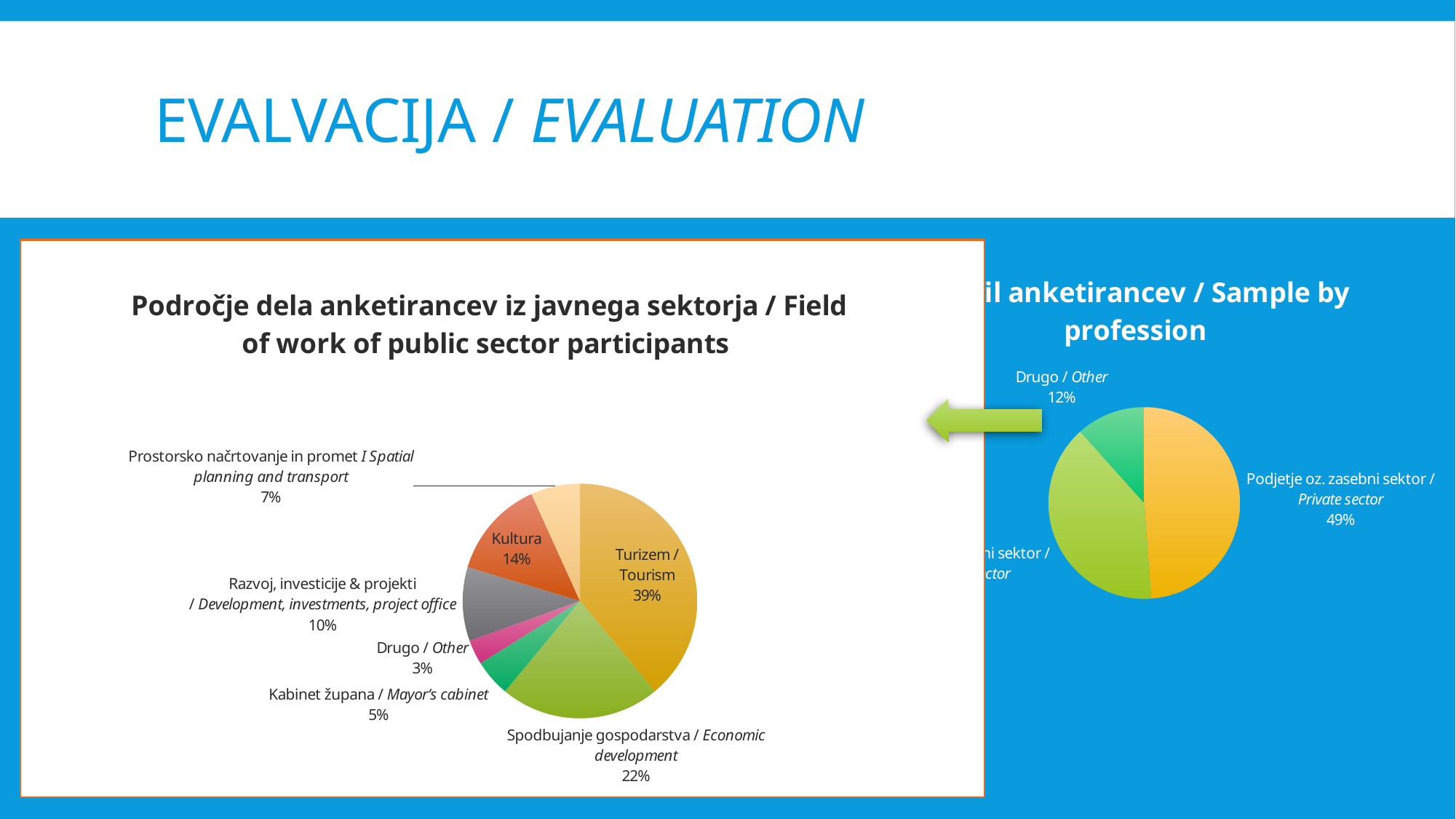
In the 'Sample by profession' chart on the right, what percentage is Drugo / Other? 12% What type of chart is the 'Field of work of public sector participants' chart? Pie chart In the 'Field of work of public sector participants' chart, which is larger: Kultura or Razvoj, investicije & projekti / Development, investments, project office? Kultura In the 'Field of work of public sector participants' chart, what percentage is Spodbujanje gospodarstva / Economic development? 22% In the 'Field of work of public sector participants' chart, what percentage is Turizem / Tourism? 39% In the 'Field of work of public sector participants' chart, which category has the smallest share? Drugo / Other In the 'Field of work of public sector participants' chart, what percentage is Kultura? 14% In the 'Field of work of public sector participants' chart, what percentage is Kabinet župana / Mayor's cabinet? 5% In the 'Field of work of public sector participants' chart, which category has the largest share? Turizem / Tourism In the 'Field of work of public sector participants' chart, what is the difference between Turizem / Tourism and Spodbujanje gospodarstva / Economic development? 17% How many slices does the 'Field of work of public sector participants' pie chart have? 7 In the 'Sample by profession' chart on the right, what percentage is Podjetje oz. zasebni sektor / Private sector? 49%